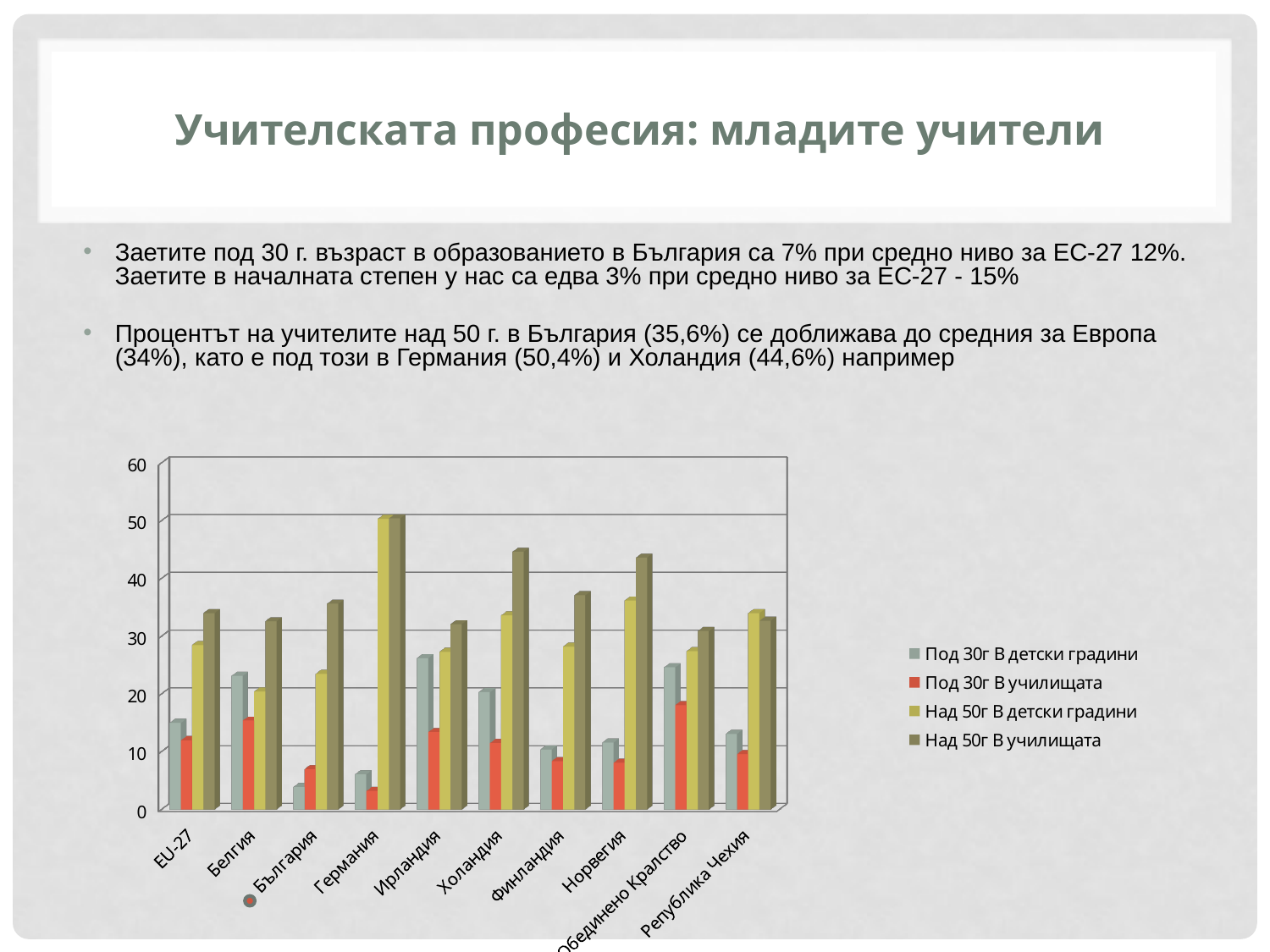
Is the value for Германия in the series "Над 50г В детски градини" greater or less than 40? greater How many series does the chart legend list? 4 Is the value for Холандия in the series "Над 50г В училищата" greater or less than 40? greater For the series "Над 50г В училищата", which is larger: Германия or България? Германия Which category has the highest value for the series "Над 50г В училищата"? Германия Is the value for Ирландия in the series "Под 30г В детски градини" greater or less than 20? greater What kind of chart is shown on the slide? bar chart Which category has the highest value for the series "Над 50г В детски градини"? Германия How many countries/categories are shown on the x axis of the chart? 10 Which series in the legend is shown in red? Под 30г В училищата Which category has the lowest value for the series "Под 30г В училищата"? Германия